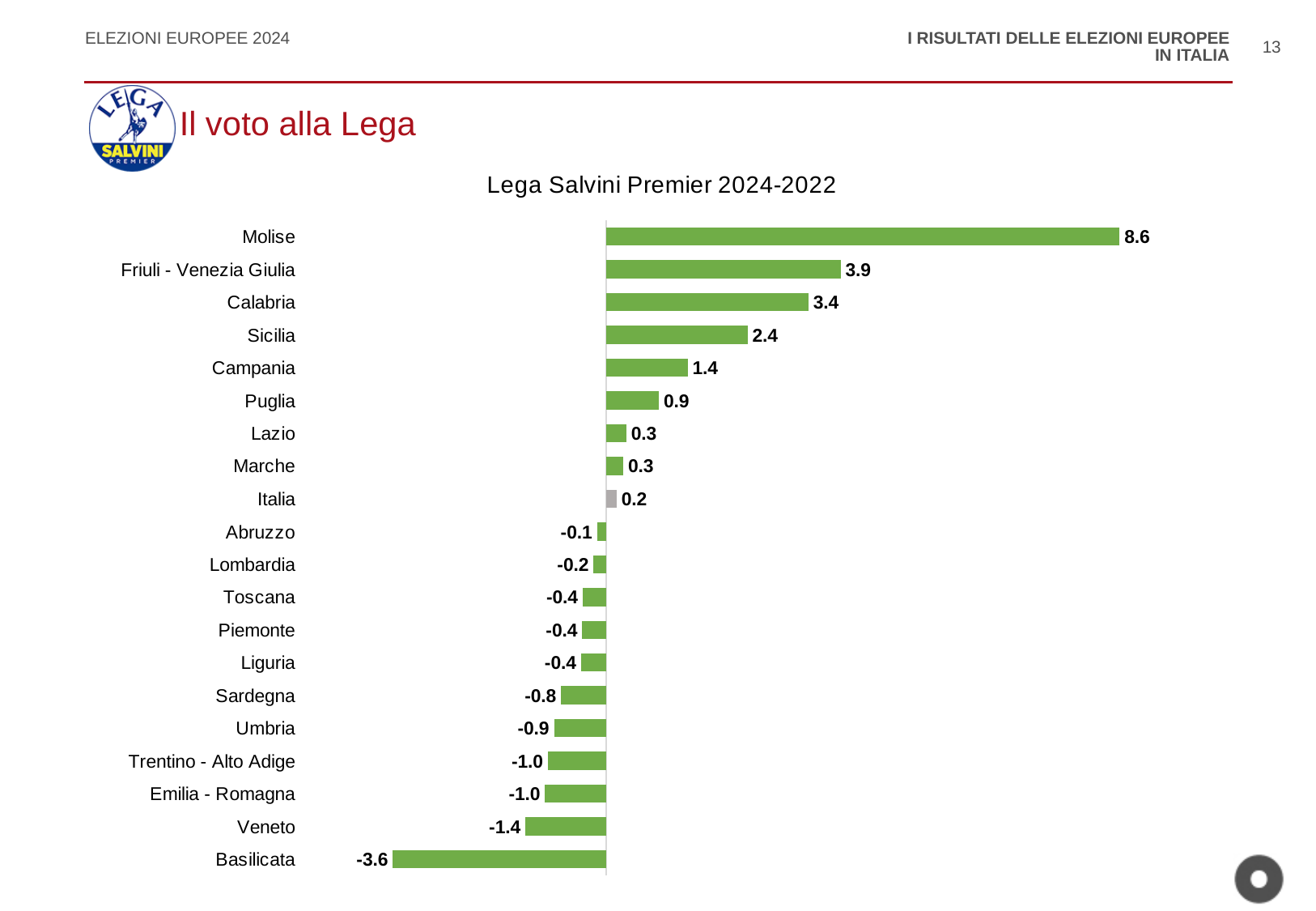
Which category has the lowest value? Basilicata Which category has the highest value? Molise How many categories are shown in the chart? 20 What is the value for Italia? 0.2 What kind of chart is shown on the slide? Bar chart What is the title of the chart? Lega Salvini Premier 2024-2022 Which is larger, the value for Calabria or the value for Sicilia? Calabria Which bar is coloured differently (grey) from the others? Italia What is the value for Molise? 8.6 What is the value for Basilicata? -3.6 What is the value for Veneto? -1.4 What is the difference between the values for Molise and Friuli - Venezia Giulia? 4.7